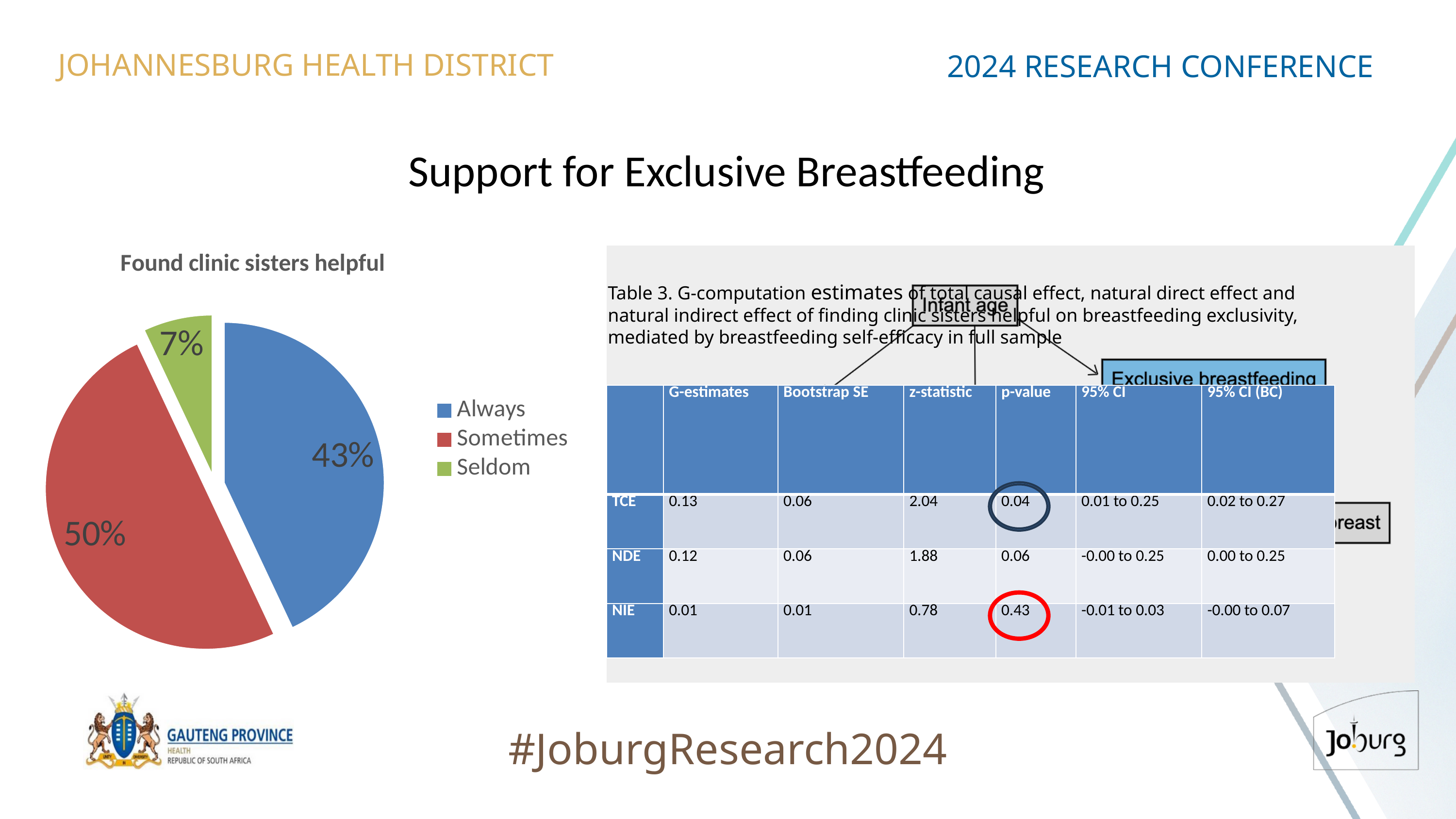
Which category has the largest slice of the pie? Sometimes What share of the pie is labelled Always? 43% What is the difference in percentage points between the Sometimes and Always slices? 7 What is the difference in percentage points between the Always and Seldom slices? 36 How many categories does the pie chart show? 3 What kind of chart is shown on the slide? pie chart What is the title of the pie chart? Found clinic sisters helpful Which category has the smallest slice of the pie? Seldom Which is larger, the Always slice or the Seldom slice? Always What share of the pie is labelled Sometimes? 50% What share of the pie is labelled Seldom? 7% What colour is the Sometimes slice in the pie chart? red